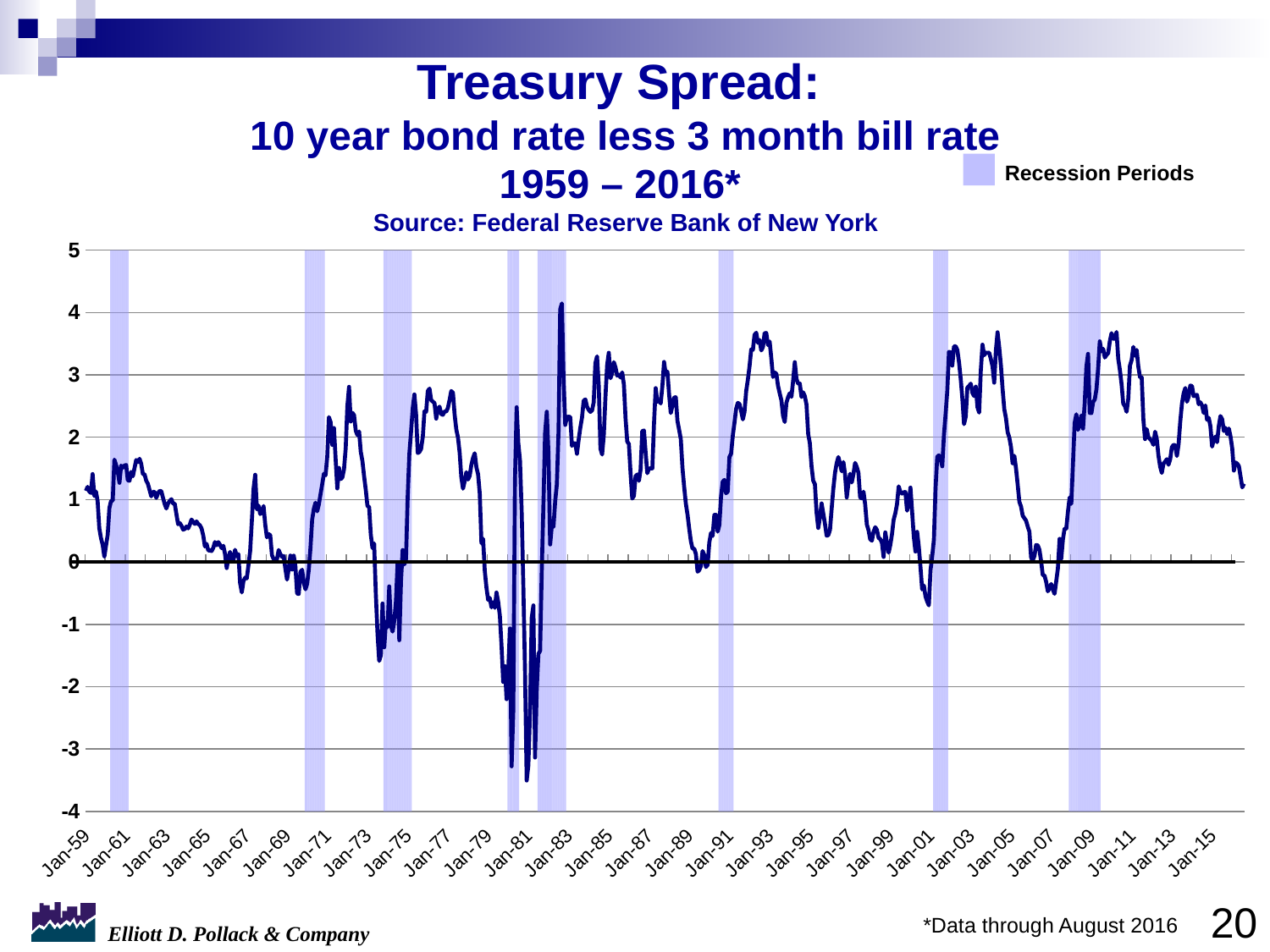
Is the lowest value of the treasury spread, reached around 1980–1981, greater or less than -3? less What is the title of the chart? Treasury Spread: 10 year bond rate less 3 month bill rate 1959 – 2016* Between Jan-07 and Jan-09, does the treasury spread rise or fall? rise Is the treasury spread at the end of the series (August 2016) greater or less than 2? less Is the treasury spread at Jan-93 greater or less than 3? greater What do the shaded vertical bands on the chart represent? Recession Periods How many year labels are shown on the x axis? 29 Between Jan-11 and Jan-15, does the treasury spread generally rise or fall? fall What kind of chart is shown on the slide? line chart